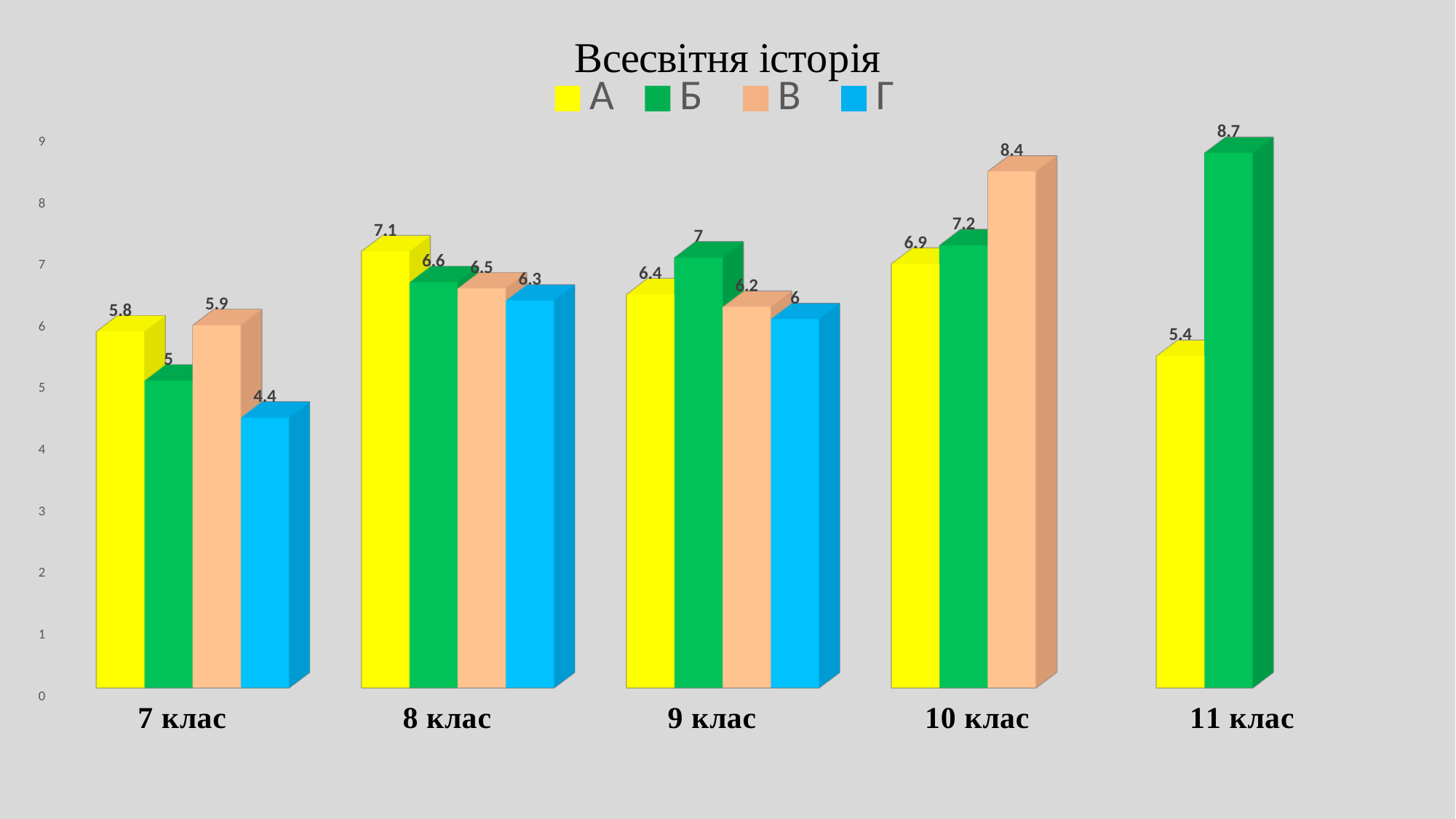
What is the value for series Б in 7 клас? 5 How many categories are shown on the x axis? 5 What is the value for series Г in 8 клас? 6.3 What kind of chart is shown? bar chart Which is larger in 9 клас: series А or series Б? Б What is the value for series В in 10 клас? 8.4 What is the difference between series Б and series А in 11 клас? 3.3 What is the title of the chart? Всесвітня історія Which category has the highest value for series Б? 11 клас Which category has the lowest value for series Г? 7 клас How many series does the legend list? 4 Is the value for series В in 10 клас greater or less than 8? greater